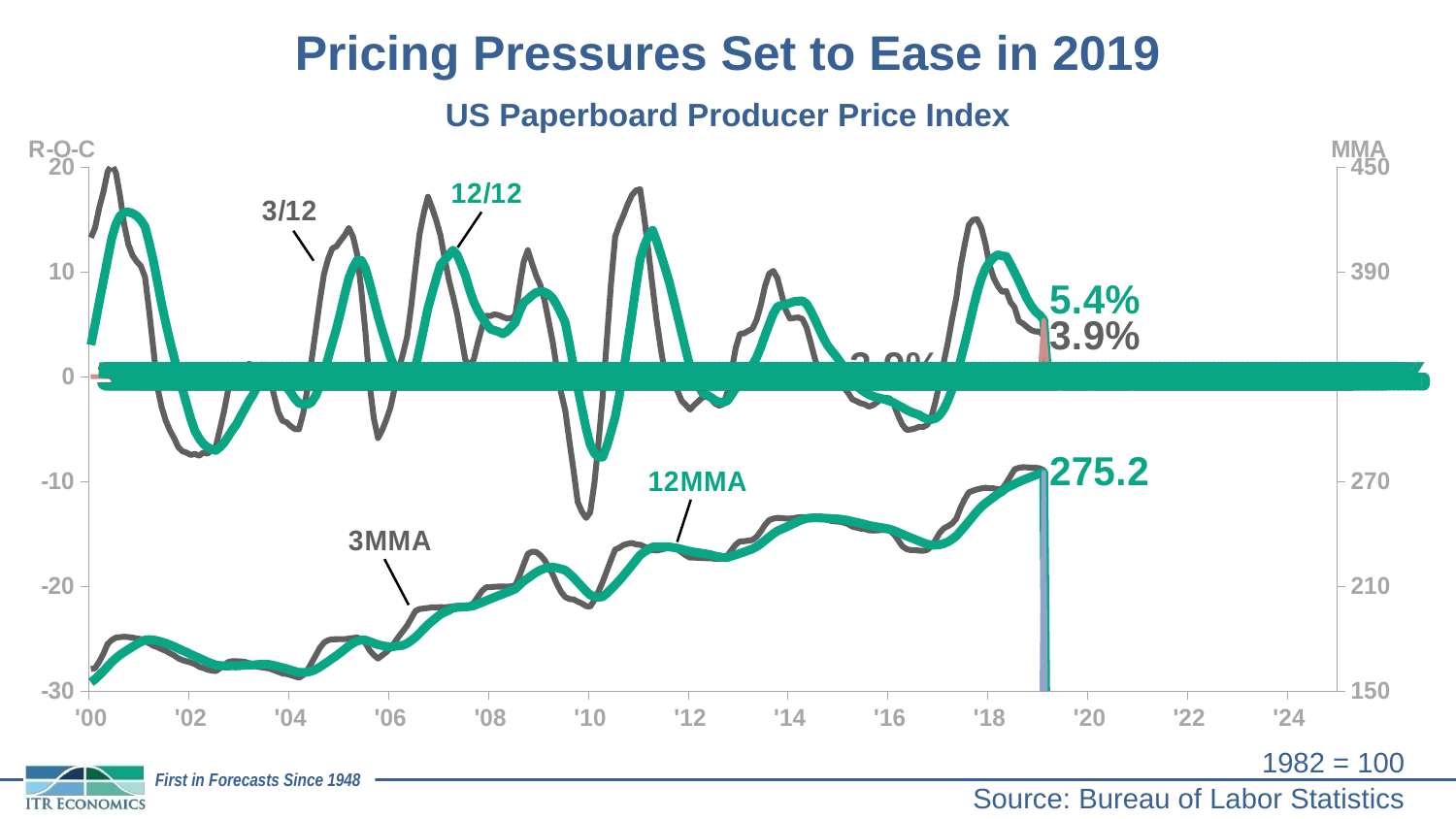
What is the difference between the latest 12/12 value (5.4%) and the latest 3/12 value (3.9%)? 1.5 percentage points What is the latest value shown for the 3/12 rate-of-change series? 3.9% What kind of chart is shown on the slide? Line chart What is the latest value shown for the 12/12 rate-of-change series? 5.4% What is the source cited for the chart data? Bureau of Labor Statistics What is the subtitle of the chart? US Paperboard Producer Price Index Is the 12MMA value at '14 greater or less than 210 on the right axis? greater What is the latest value shown for the 12MMA series? 275.2 Is the 12MMA value at '00 greater or less than 210 on the right axis? less Does the 12MMA series generally rise or fall from '00 to '18? Rise Which is larger at the latest data point, the 12/12 value or the 3/12 value? 12/12 How many data series are labeled on the chart? 4